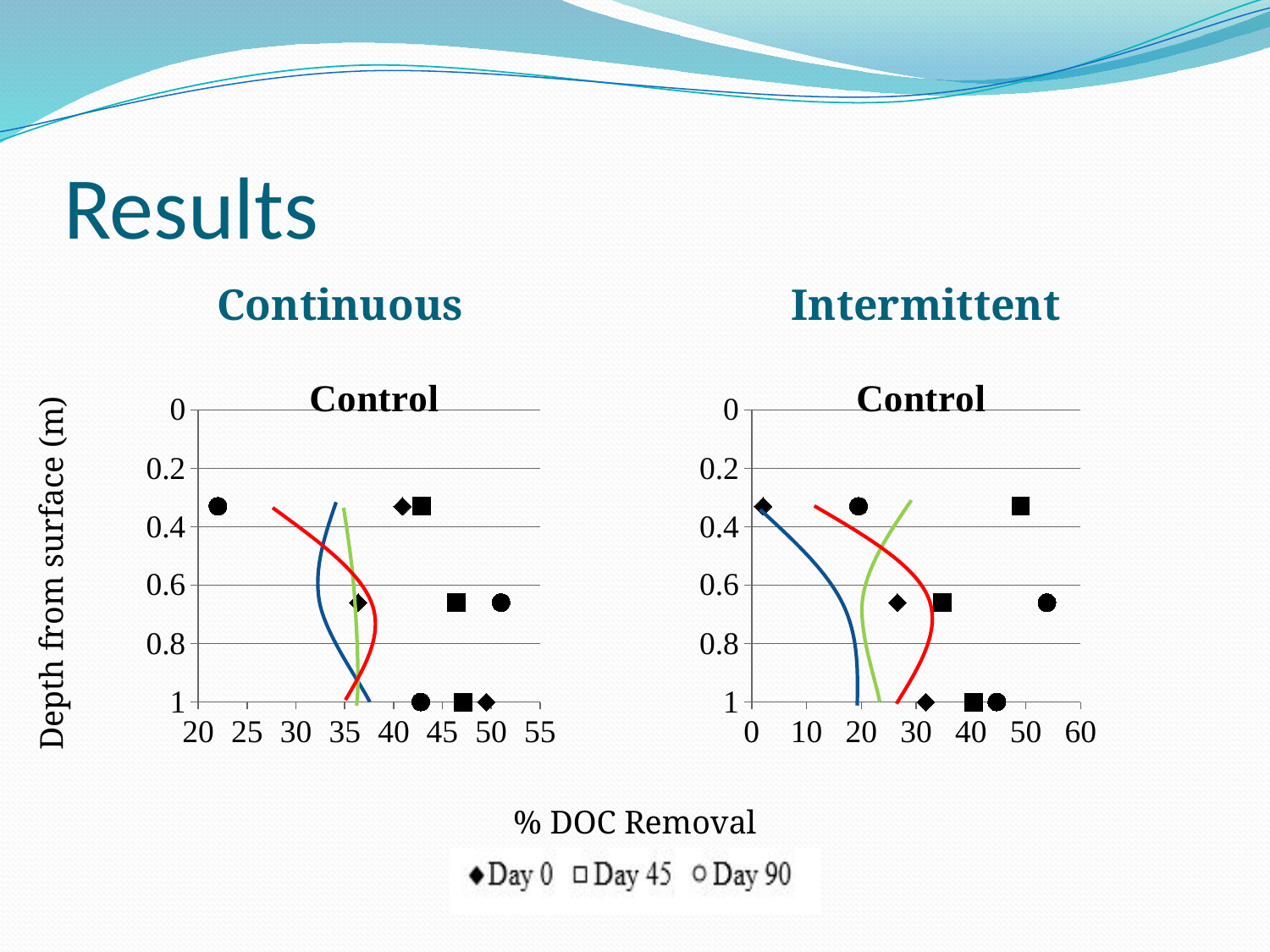
In the Intermittent chart, is the Day 0 value at the shallowest depth greater or less than 10? less In the Continuous chart, is the Day 90 value at the shallowest depth greater or less than 25? less In the Intermittent chart, is the Day 45 value at the shallowest depth greater or less than 40? greater In the Intermittent chart, at the shallowest depth, which is larger: the Day 0 value or the Day 45 value? Day 45 What is the x-axis label shared by the two charts? % DOC Removal What are the three series named in the legend? Day 0, Day 45, Day 90 How many series does the legend list? 3 In the Continuous chart, how many Day 90 points are plotted? 3 What kind of chart is the Continuous chart? scatter chart In the Intermittent chart, how many data points are plotted in total across all series? 9 In the Continuous chart, at the shallowest depth, which is larger: the Day 45 value or the Day 90 value? Day 45